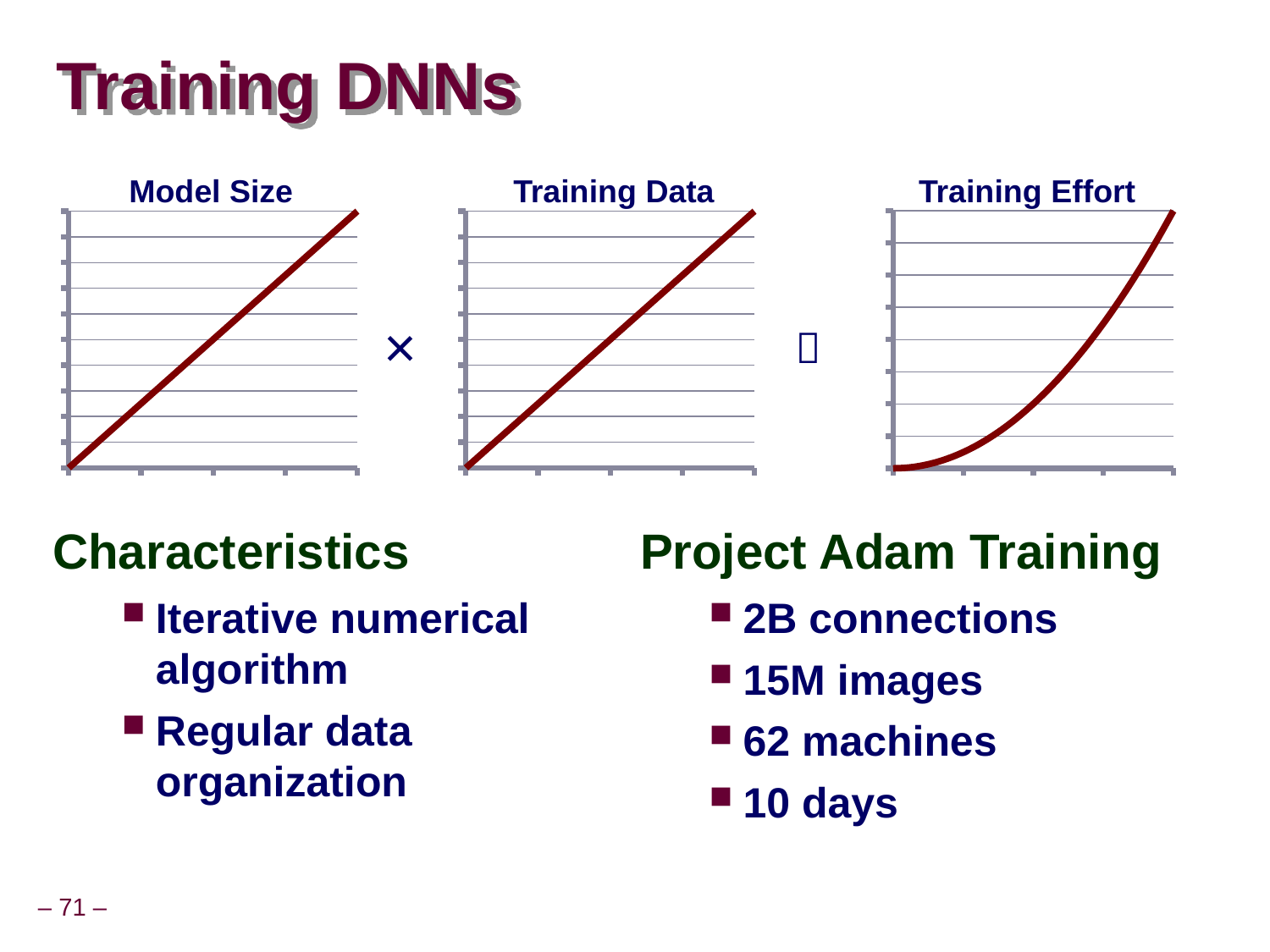
In the "Training Data" chart, does the line rise or fall along the x axis? rise In the "Model Size" chart, does the line rise or fall along the x axis? rise What kind of chart is the "Training Effort" chart? line chart What is the title of the rightmost chart on the slide? Training Effort In the "Training Effort" chart, does the line rise or fall along the x axis? rise What kind of chart is the "Model Size" chart? line chart What is the title of the middle chart on the slide? Training Data How many charts are shown on the slide? 3